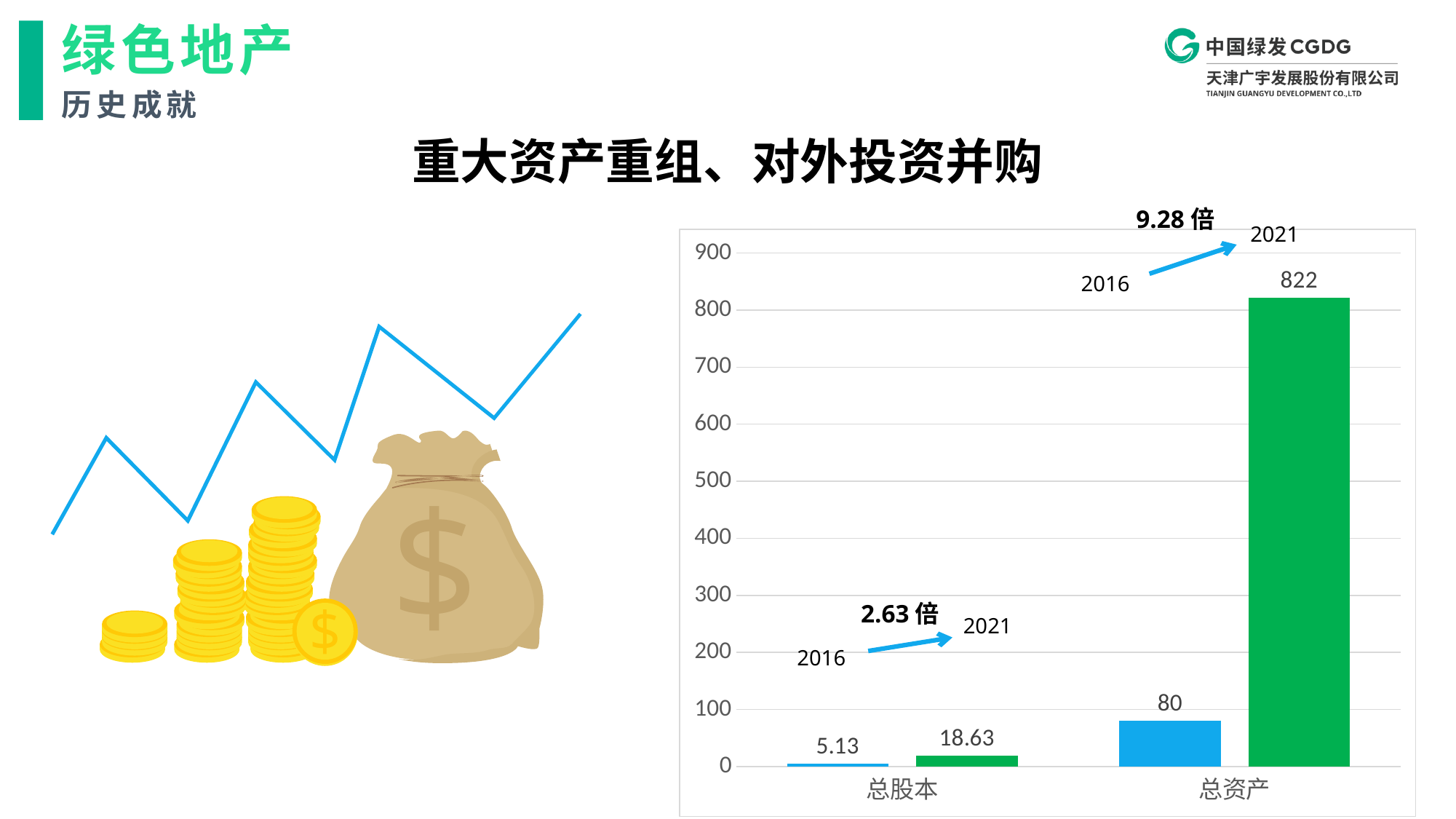
Which bar in the chart has the lowest value? 总股本 2016 Which bar in the chart has the highest value? 总资产 2021 What multiple is annotated above the 总资产 bars in the chart? 9.28 倍 What is the 2021 value for 总股本? 18.63 What is the 2021 value for 总资产? 822 What is the difference between the 2021 and 2016 values for 总资产? 742 What is the difference between the 2021 and 2016 values for 总股本? 13.5 What is the 2016 value for 总资产? 80 What kind of chart is shown on the slide? Bar chart What is the 2016 value for 总股本? 5.13 How many categories are shown on the x axis of the chart? 2 Which is larger, the 2016 value for 总资产 or the 2021 value for 总股本? 2016 value for 总资产